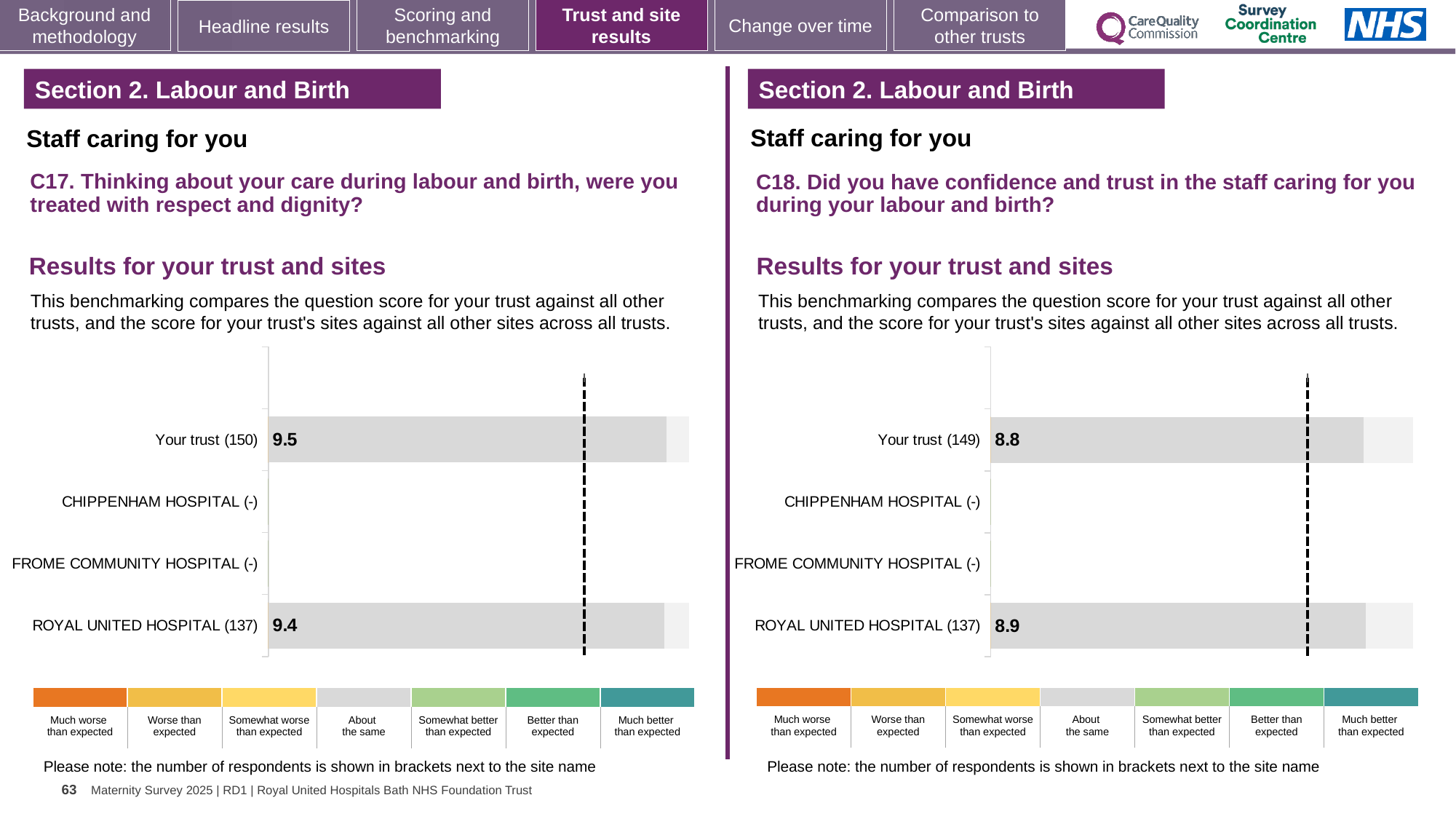
How many site or trust categories are listed on the y axis of the C17 chart on the left? 4 In the C17 chart on the left, what is the score for Your trust? 9.5 What kind of chart is used in the C18 chart on the right? Bar chart In the C18 chart on the right, what is the difference between the score for Royal United Hospital and the score for Your trust? 0.1 In the C17 chart on the left, how many respondents are shown in brackets for Your trust? 150 In the C17 chart on the left, which has the higher score: Your trust or Royal United Hospital? Your trust In the C18 chart on the right, how many respondents are shown in brackets for Royal United Hospital? 137 In the C18 chart on the right, which has the higher score: Your trust or Royal United Hospital? Royal United Hospital In the C18 chart on the right, what is the score for Royal United Hospital? 8.9 In the C17 chart on the left, what is the score for Royal United Hospital? 9.4 In the C18 chart on the right, what is the score for Your trust? 8.8 In the C17 chart on the left, what is the difference between the score for Your trust and the score for Royal United Hospital? 0.1